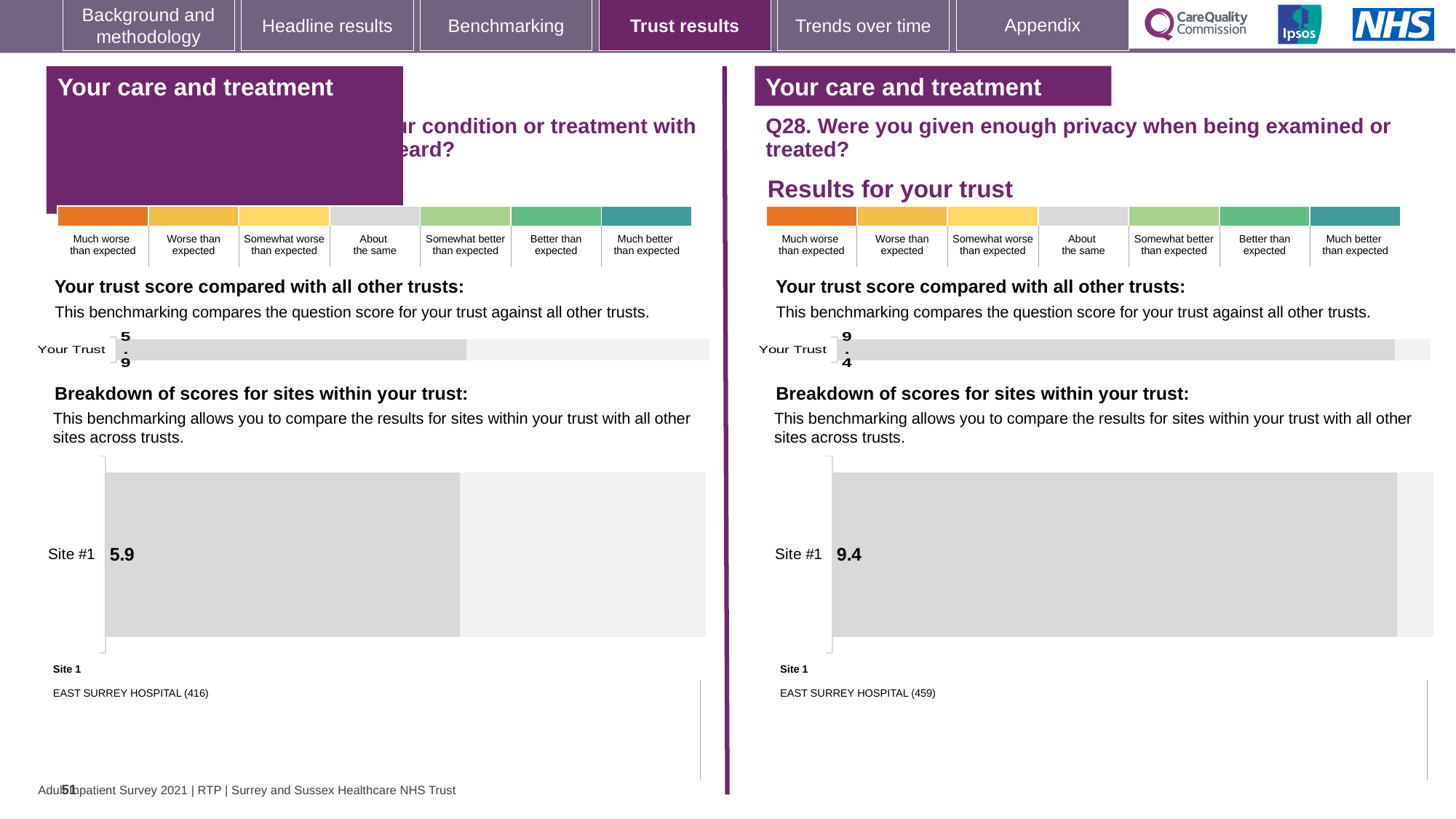
What is the difference between the Your Trust score on the right half of the slide (9.4) and the Your Trust score on the left half (5.9)? 3.5 How many sites are shown in the left 'Breakdown of scores for sites within your trust' chart? 1 Which hospital is listed as Site 1 under the right breakdown chart? EAST SURREY HOSPITAL (459) In the left 'Breakdown of scores for sites within your trust' chart, what is the score for Site #1? 5.9 Which is larger: the Site #1 score in the left breakdown chart or the Site #1 score in the right breakdown chart? The right chart (9.4) On the right half of the slide (Q28), what is the score shown for Your Trust in the 'Your trust score compared with all other trusts' chart? 9.4 On the left half of the slide, what is the score shown for Your Trust in the 'Your trust score compared with all other trusts' chart? 5.9 How many sites are shown in the right 'Breakdown of scores for sites within your trust' chart? 1 In the right 'Breakdown of scores for sites within your trust' chart (Q28), what is the score for Site #1? 9.4 Which hospital is listed as Site 1 under the left breakdown chart? EAST SURREY HOSPITAL (416) What type of chart is used to show the Site #1 score in the breakdown sections? Bar chart Is the Site #1 score in the left breakdown chart equal to the Your Trust score on the left half of the slide? Yes, both are 5.9